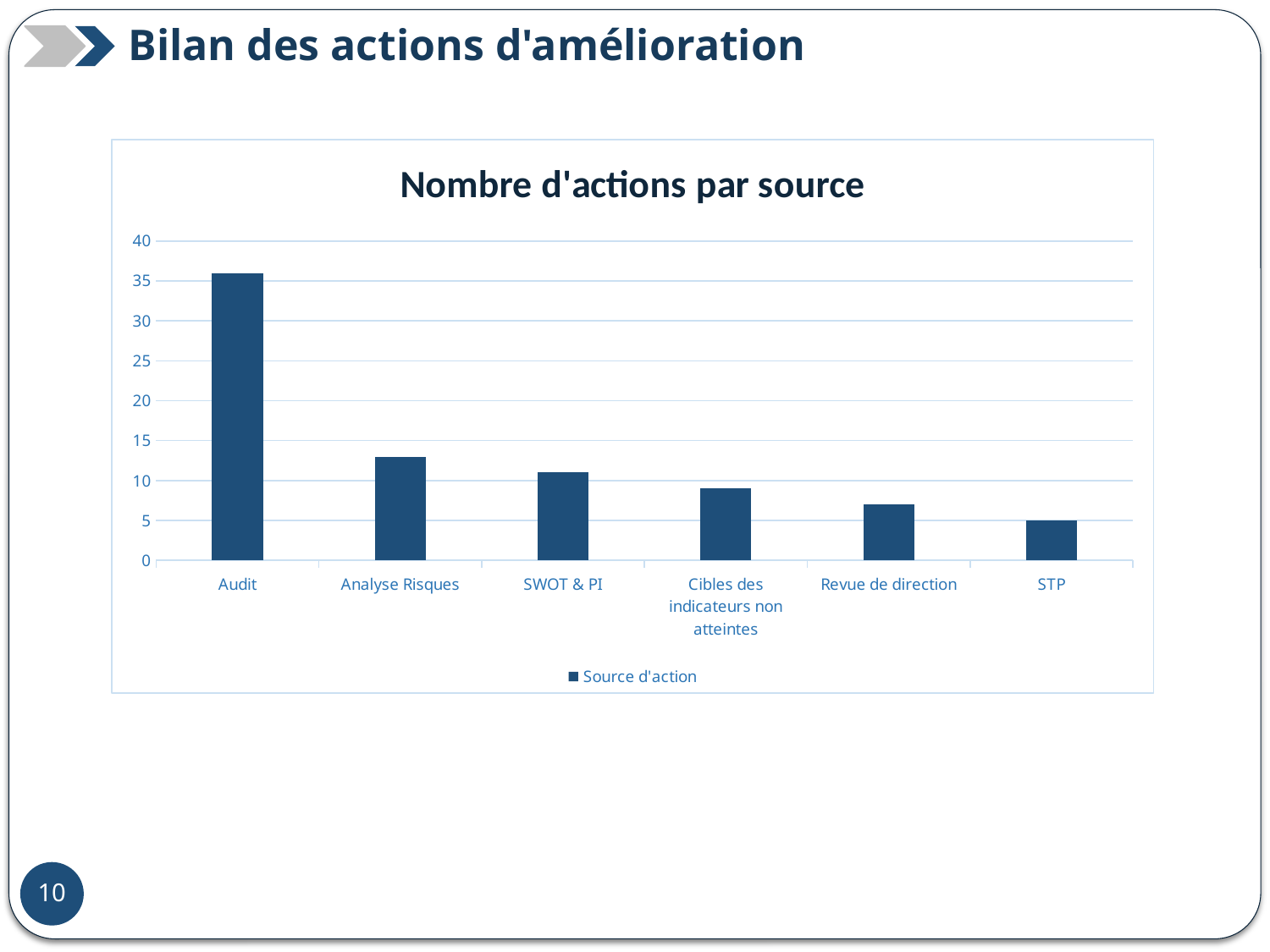
Is the value for Revue de direction greater or less than 10? less Is the value for Analyse Risques greater or less than 10? greater What is the title of the chart? Nombre d'actions par source What type of chart is shown on the slide? bar chart How many categories are shown on the x axis of the chart? 6 Do the values rise or fall from left to right along the x axis? fall Is the value for Audit greater or less than 30? greater How many series does the legend list? 1 Which source has the lowest number of actions? STP Which source has the highest number of actions? Audit What is the name of the series shown in the legend? Source d'action Which has more actions, Analyse Risques or SWOT & PI? Analyse Risques